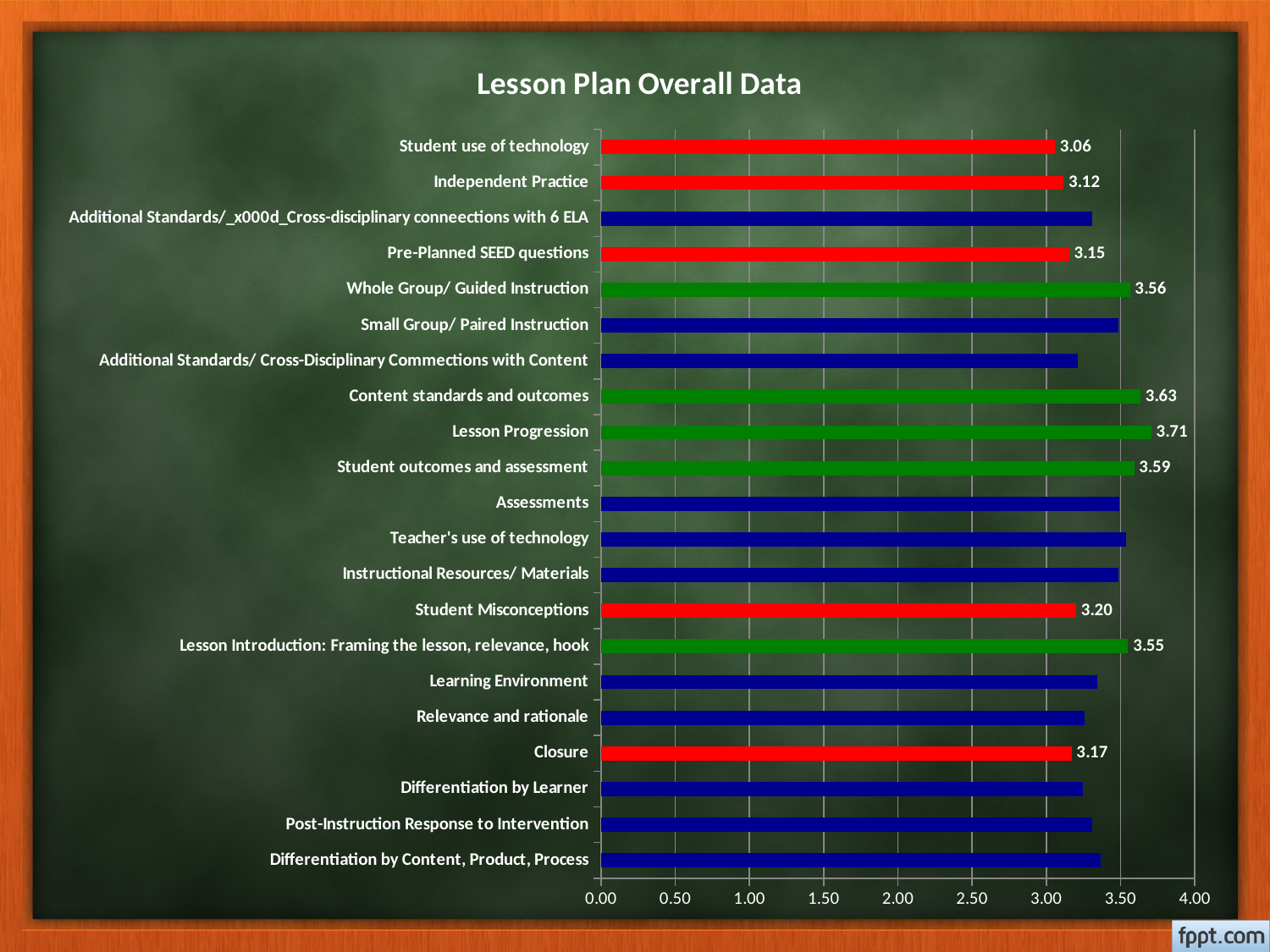
Which category has the highest value? Lesson Progression What is the value for Student Misconceptions? 3.20 What is the value for Lesson Progression? 3.71 What is the value for Whole Group/ Guided Instruction? 3.56 Which is larger, the value for Closure or the value for Pre-Planned SEED questions? Closure What kind of chart is shown on the slide? Bar chart How many categories are shown in the chart? 21 What is the difference between the values for Content standards and outcomes and Whole Group/ Guided Instruction? 0.07 Is the value for Differentiation by Content, Product, Process greater or less than 3.00? greater Which category has the lowest value? Student use of technology What is the difference between the values for Lesson Progression and Student use of technology? 0.65 Is the value for Learning Environment greater or less than 3.50? less